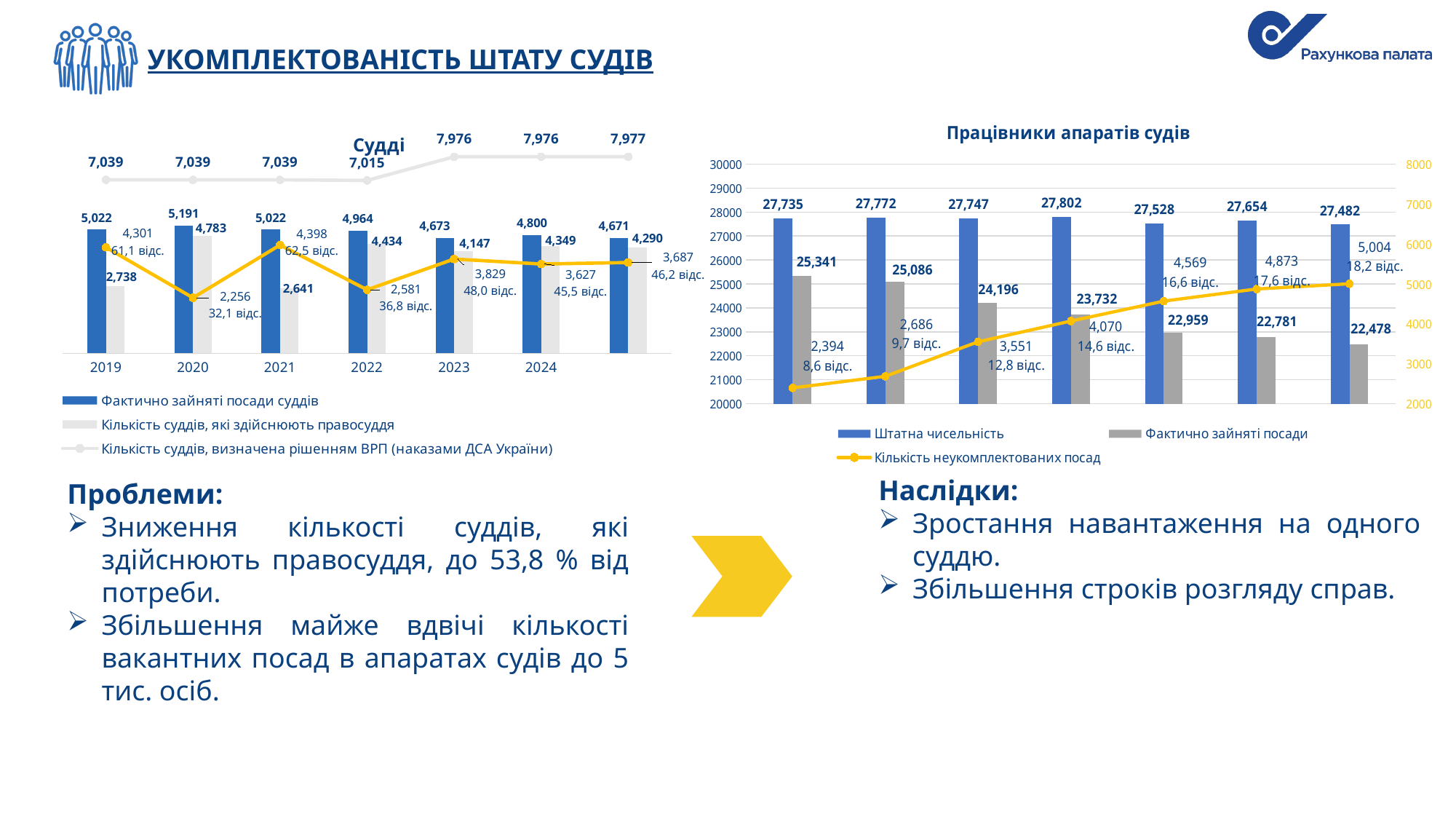
In the left chart (Судді), what is the value of Фактично зайняті посади суддів for 2020? 5,191 In the left chart (Судді), what is the difference between Фактично зайняті посади суддів and Кількість суддів, які здійснюють правосуддя in 2022? 530 In the left chart (Судді), which year has the highest value for Фактично зайняті посади суддів? 2020 In the right chart (Працівники апаратів судів), what is the difference between Штатна чисельність and Фактично зайняті посади in the leftmost group? 2,394 In the right chart (Працівники апаратів судів), what is the lowest value shown for Фактично зайняті посади? 22,478 In the left chart (Судді), which year has the larger value for Кількість суддів, які здійснюють правосуддя: 2021 or 2022? 2022 How many groups of bars are plotted in the right chart (Працівники апаратів судів)? 7 In the left chart (Судді), what is the value of Кількість суддів, визначена рішенням ВРП for 2023? 7,976 What kind of chart is the right chart (Працівники апаратів судів)? Bar chart with a line series In the right chart (Працівники апаратів судів), what is the highest value shown for Штатна чисельність? 27,802 How many series does the legend of the left chart (Судді) list? 3 In the right chart (Працівники апаратів судів), does the line Кількість неукомплектованих посад rise or fall from left to right? Rises